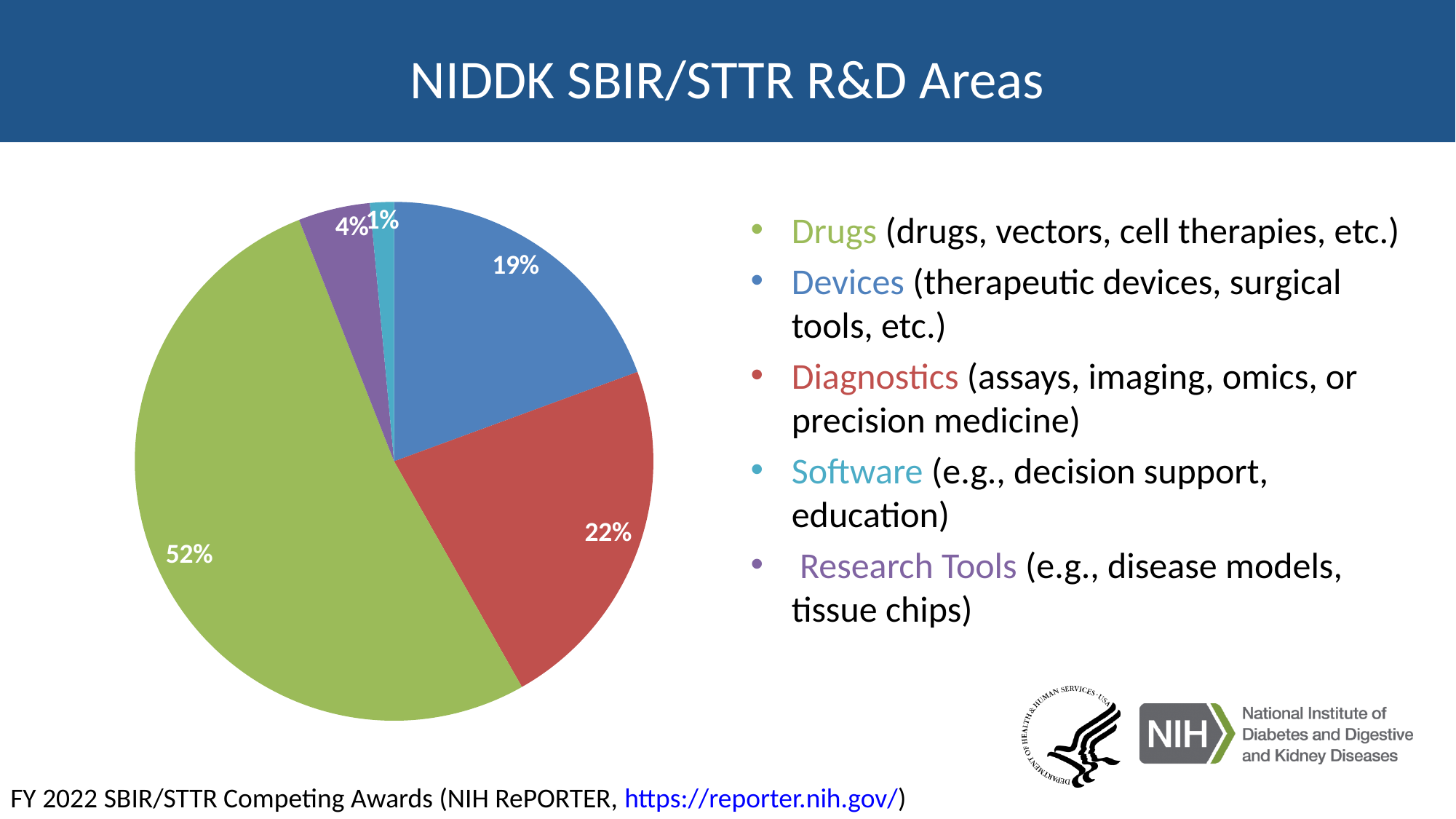
What percentage is shown for the Devices slice (blue)? 19% What percentage is shown for the Software slice (teal)? 1% What colour is the slice representing Research Tools? purple What percentage is shown for the Research Tools slice (purple)? 4% Which R&D area has the largest share of the pie? Drugs Which R&D area has the smallest share of the pie? Software What kind of chart is shown on the slide? pie chart What share of the pie does the Drugs slice (green) represent? 52% How many slices does the pie chart have? 5 Which is larger, the Diagnostics share or the Devices share? Diagnostics What is the difference in percentage points between the Drugs share and the Diagnostics share? 30 What percentage is shown for the Diagnostics slice (red)? 22%